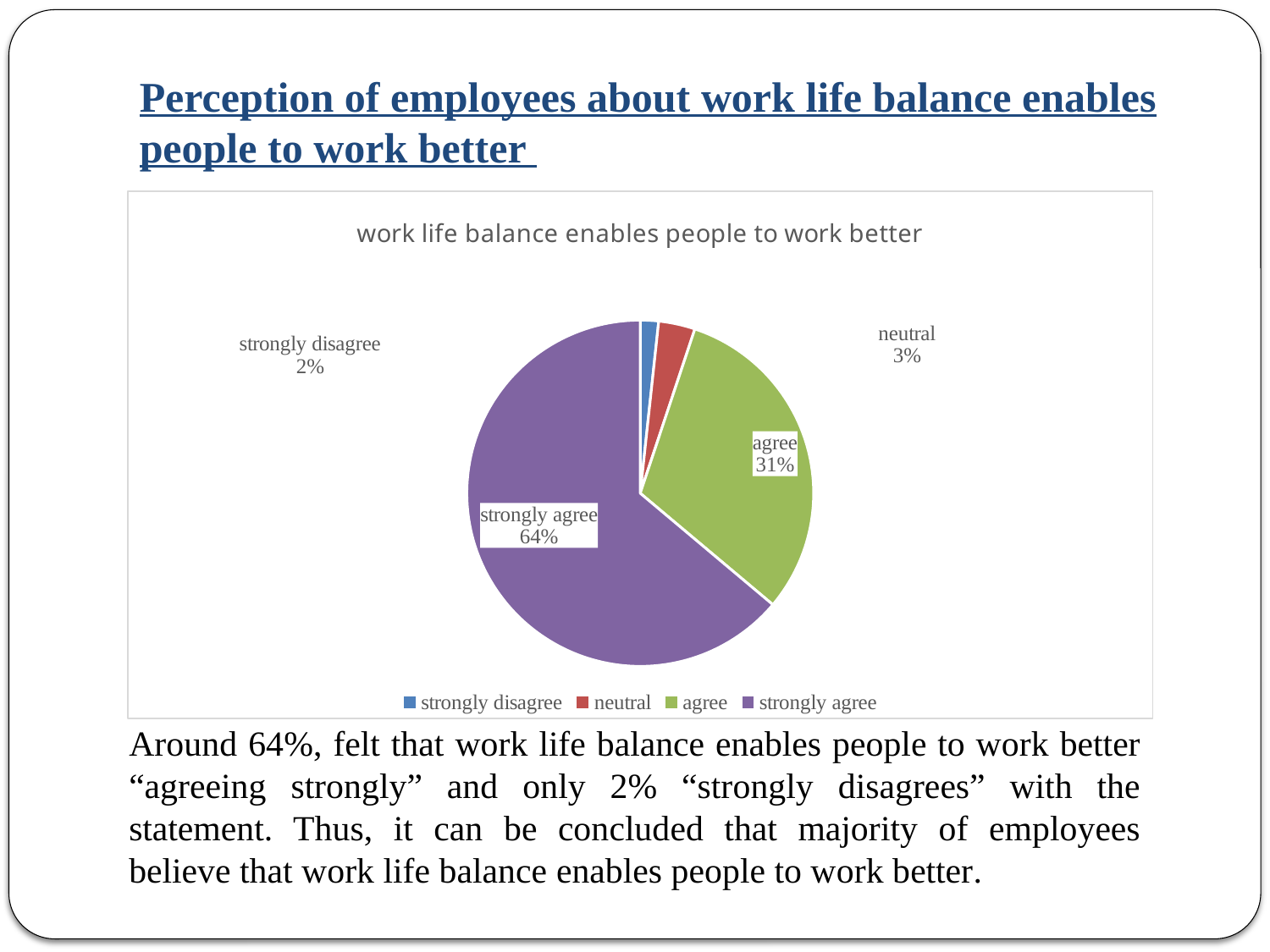
What percentage of the pie is labelled "neutral"? 3% What is the title of the chart? work life balance enables people to work better What type of chart is shown on the slide? pie chart Which is larger, the share for "neutral" or the share for "strongly disagree"? neutral Which colour represents "agree" in the pie chart? green How many categories does the pie chart show? 4 Which category has the smallest share of the pie? strongly disagree What percentage of the pie is labelled "agree"? 31% What percentage of the pie is labelled "strongly disagree"? 2% Which category has the largest share of the pie? strongly agree What is the difference in percentage points between "strongly agree" and "agree"? 33 What percentage of the pie is labelled "strongly agree"? 64%